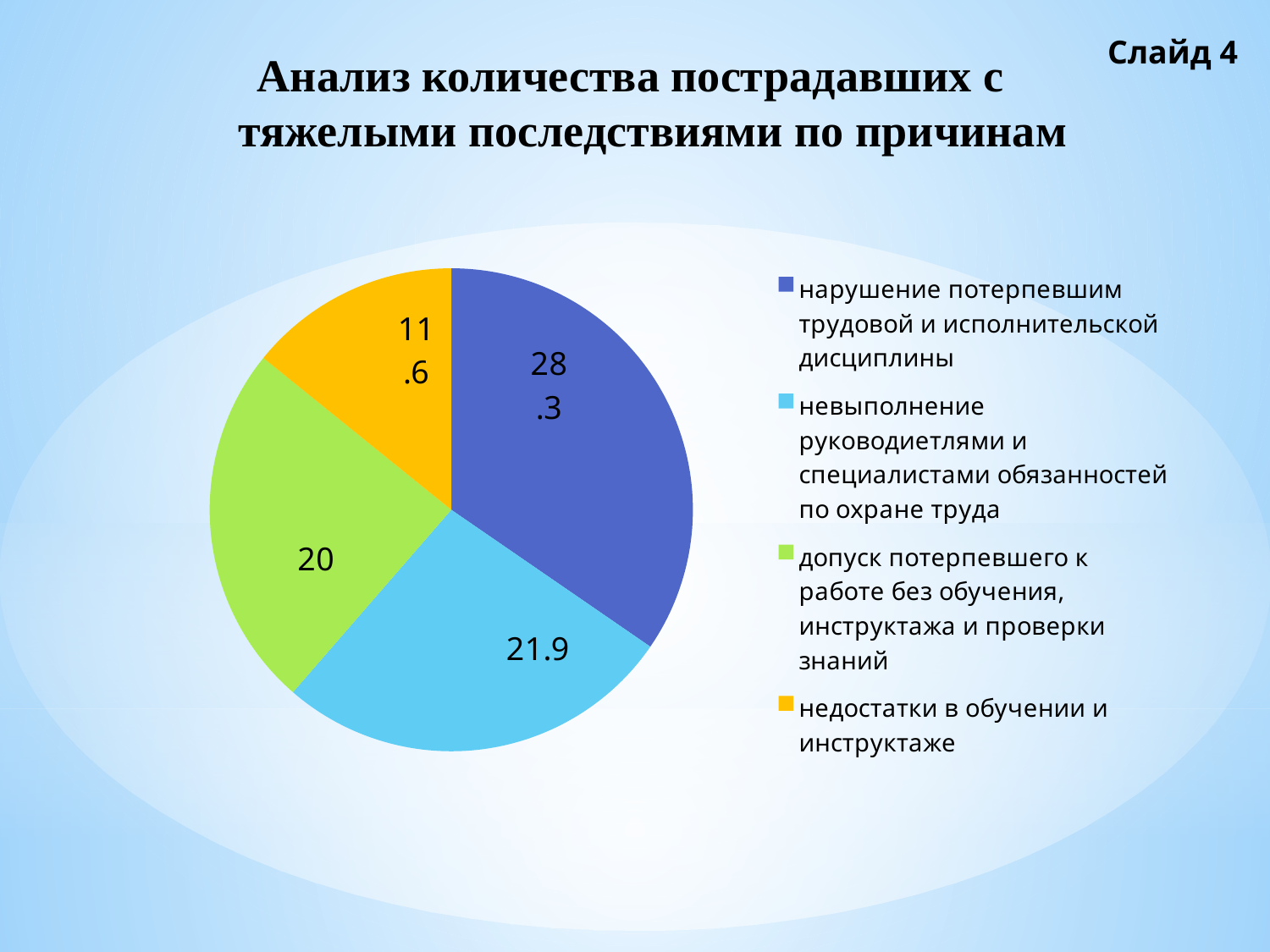
Which category has the largest slice of the pie? нарушение потерпевшим трудовой и исполнительской дисциплины How many slices does the pie chart have? 4 What is the difference between the values for "нарушение потерпевшим трудовой и исполнительской дисциплины" and "недостатки в обучении и инструктаже"? 16.7 What kind of chart is shown on the slide? pie chart What colour is the slice for "недостатки в обучении и инструктаже"? orange What is the value for the slice "допуск потерпевшего к работе без обучения, инструктажа и проверки знаний"? 20 What is the value for the slice "недостатки в обучении и инструктаже"? 11.6 What is the value for the slice "невыполнение руководиетлями и специалистами обязанностей по охране труда"? 21.9 Which is larger: the value for "допуск потерпевшего к работе без обучения, инструктажа и проверки знаний" or the value for "недостатки в обучении и инструктаже"? допуск потерпевшего к работе без обучения, инструктажа и проверки знаний Which category has the smallest slice of the pie? недостатки в обучении и инструктаже What is the difference between the values for "невыполнение руководиетлями и специалистами обязанностей по охране труда" and "допуск потерпевшего к работе без обучения, инструктажа и проверки знаний"? 1.9 What is the value for the slice "нарушение потерпевшим трудовой и исполнительской дисциплины"? 28.3